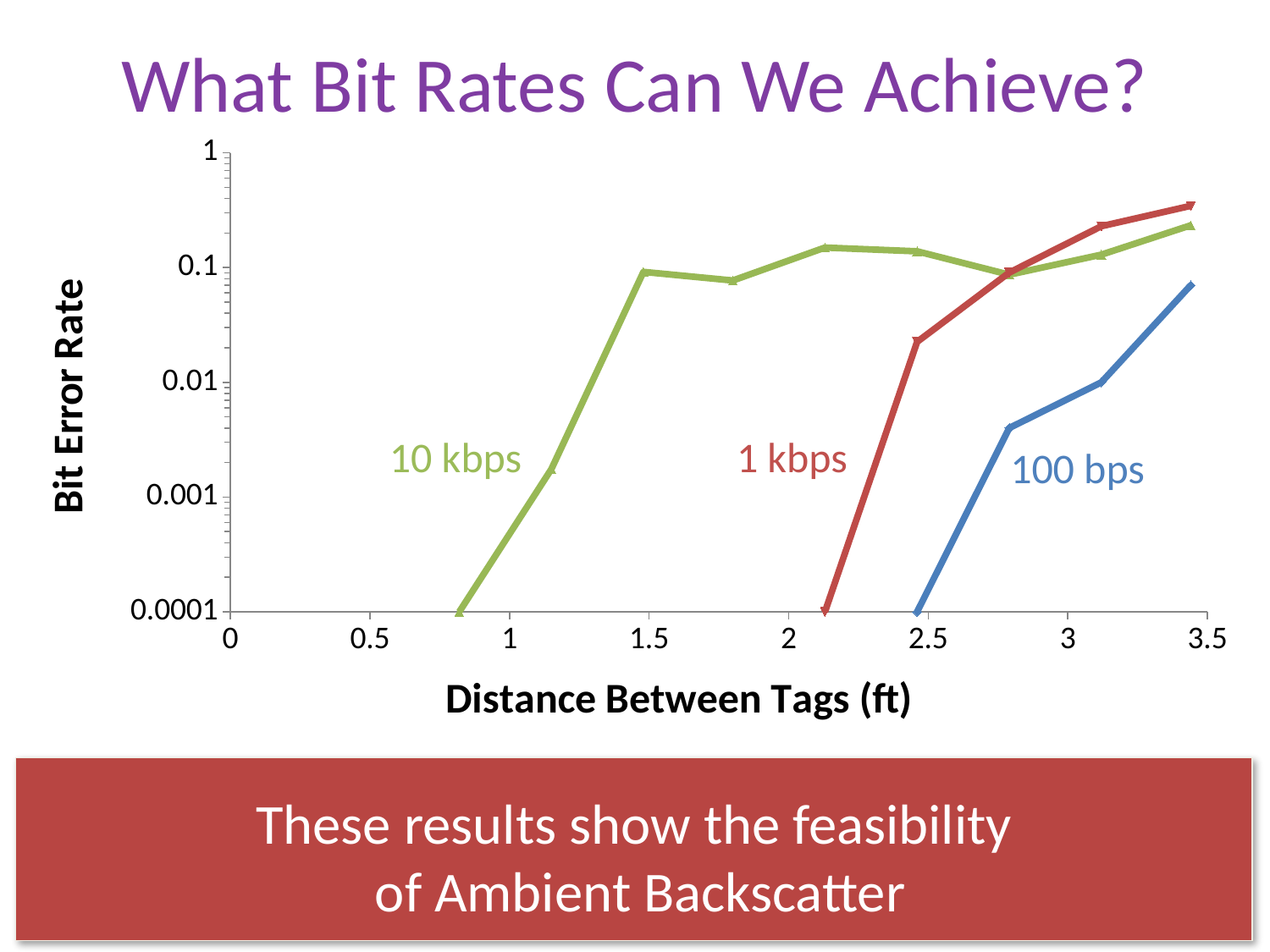
At a distance of 3 ft, which has the higher bit error rate, 10 kbps or 100 bps? 10 kbps Is the bit error rate for 1 kbps at 2.5 ft greater or less than 0.01? greater What is the label of the x axis of the chart? Distance Between Tags (ft) How does the bit error rate change as the distance between tags increases for each bit rate? It rises At a distance of 3 ft, which has the higher bit error rate, 1 kbps or 100 bps? 1 kbps Which bit rate has the lowest bit error rate at a distance of 3 ft? 100 bps Which bit rate reaches a bit error rate of 0.1 at the shortest distance between tags? 10 kbps What is the title of the slide containing the chart? What Bit Rates Can We Achieve? What kind of chart is shown on the slide? line chart How many data series (bit rates) are plotted on the chart? 3 Is the bit error rate for 100 bps at 3.5 ft greater or less than 0.1? less